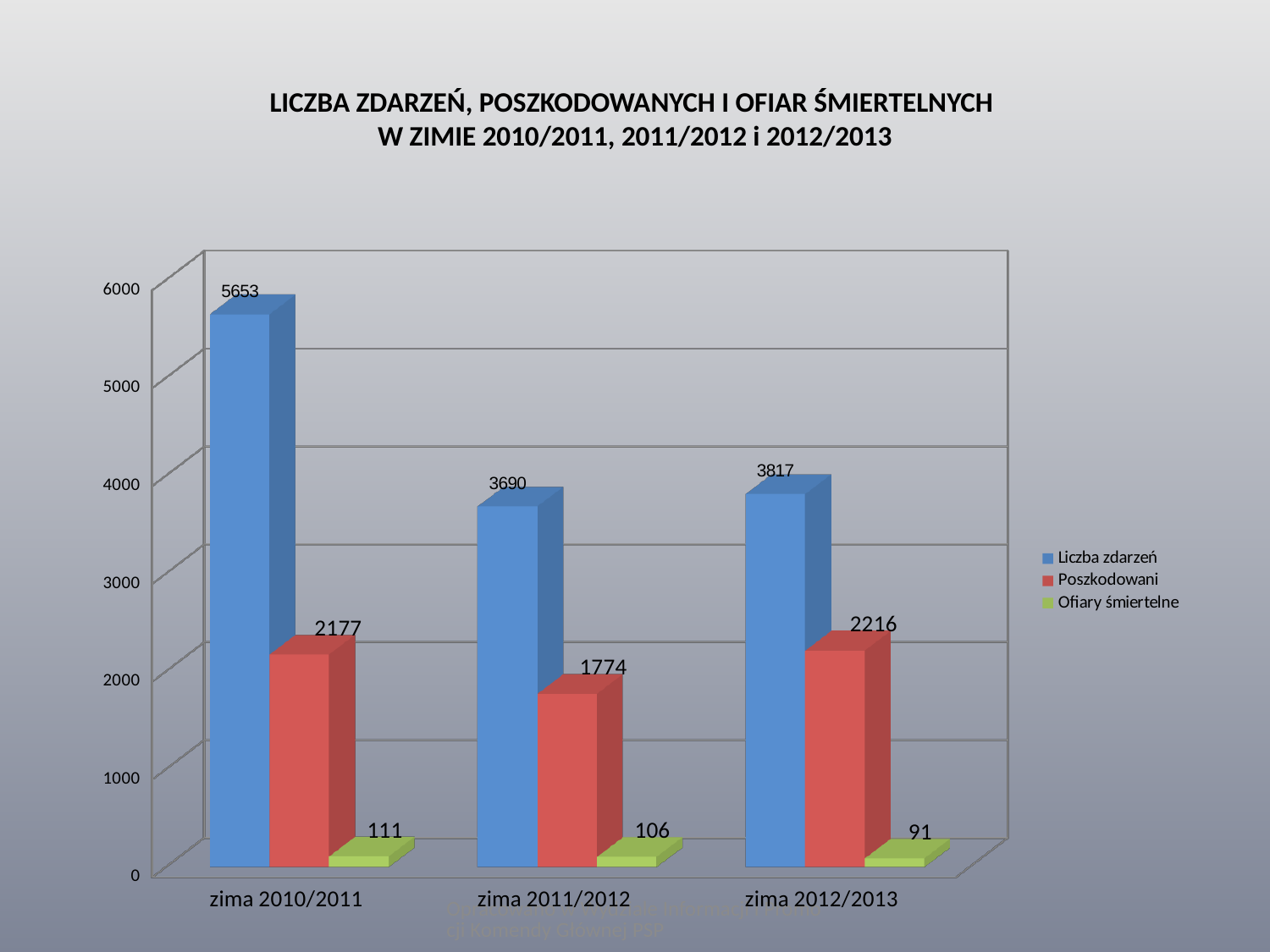
What kind of chart is shown on the slide? bar chart Which is larger: Poszkodowani for zima 2010/2011 or for zima 2012/2013? zima 2012/2013 Is the value of Liczba zdarzeń for zima 2012/2013 greater or less than 4000? less How many series does the legend list? 3 What is the value of Ofiary śmiertelne for zima 2012/2013? 91 How many winter seasons are shown on the x axis? 3 What is the difference between Liczba zdarzeń for zima 2010/2011 and zima 2011/2012? 1963 Which winter has the highest value of Liczba zdarzeń? zima 2010/2011 Which winter has the lowest value of Poszkodowani? zima 2011/2012 Which colour represents Ofiary śmiertelne in the legend? green What is the value of Liczba zdarzeń for zima 2010/2011? 5653 What is the value of Poszkodowani for zima 2011/2012? 1774